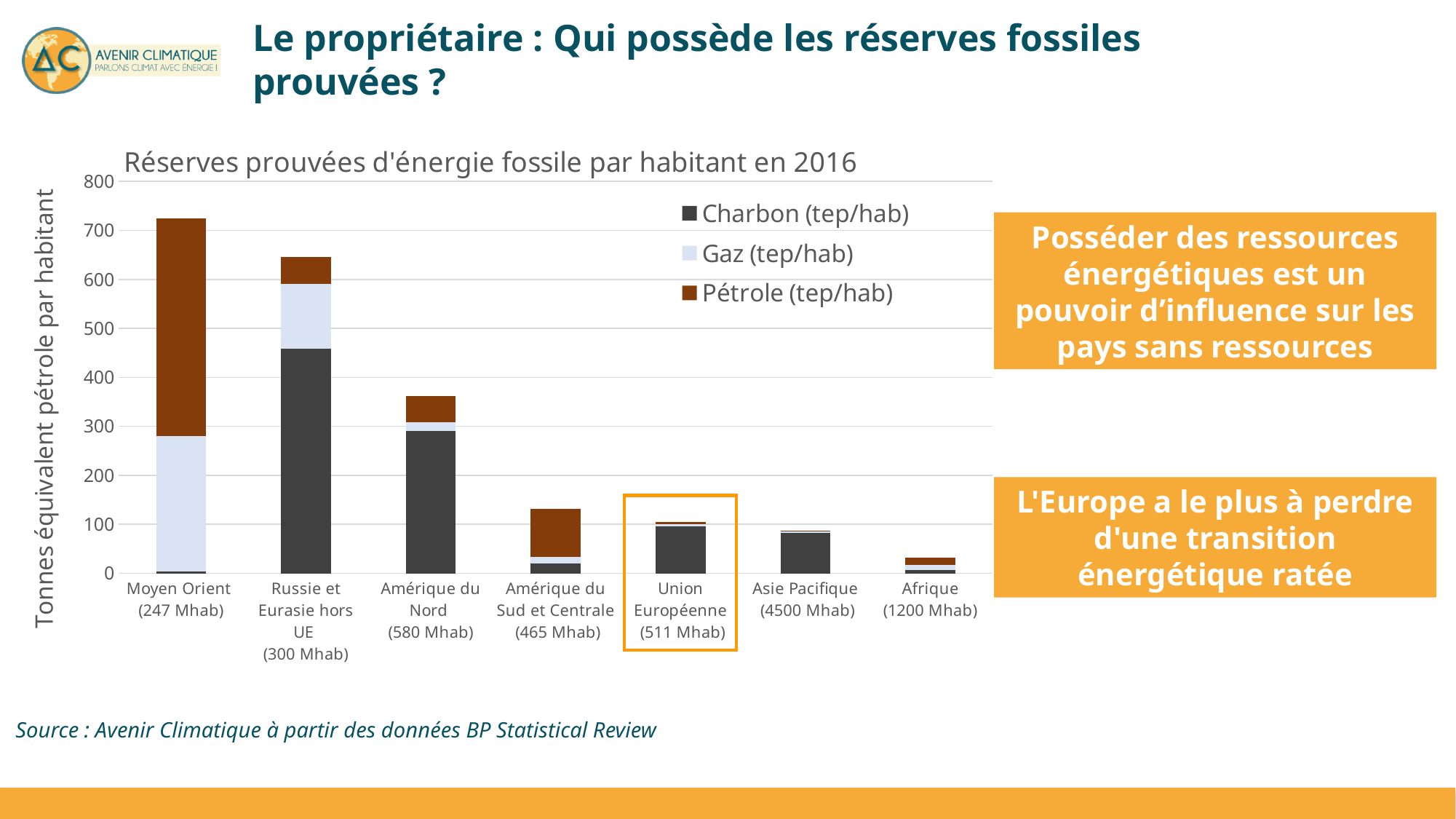
Which region has the lowest total proven fossil reserves per inhabitant? Afrique Which region has the largest Charbon (tep/hab) segment? Russie et Eurasie hors UE Which region's bar is highlighted with an orange box on the chart? Union Européenne What is the title of the chart? Réserves prouvées d'énergie fossile par habitant en 2016 How many regions (categories) are shown on the x axis of the chart? 7 What kind of chart is shown on the slide? Stacked bar chart How many series does the chart legend list? 3 Is the total value for Moyen Orient greater or less than 600? greater Is the total value for Asie Pacifique greater or less than 100? less Is the total value for Amérique du Nord greater or less than 300? greater Which has a larger total bar: Russie et Eurasie hors UE or Amérique du Nord? Russie et Eurasie hors UE Which region has the highest total proven fossil reserves per inhabitant? Moyen Orient